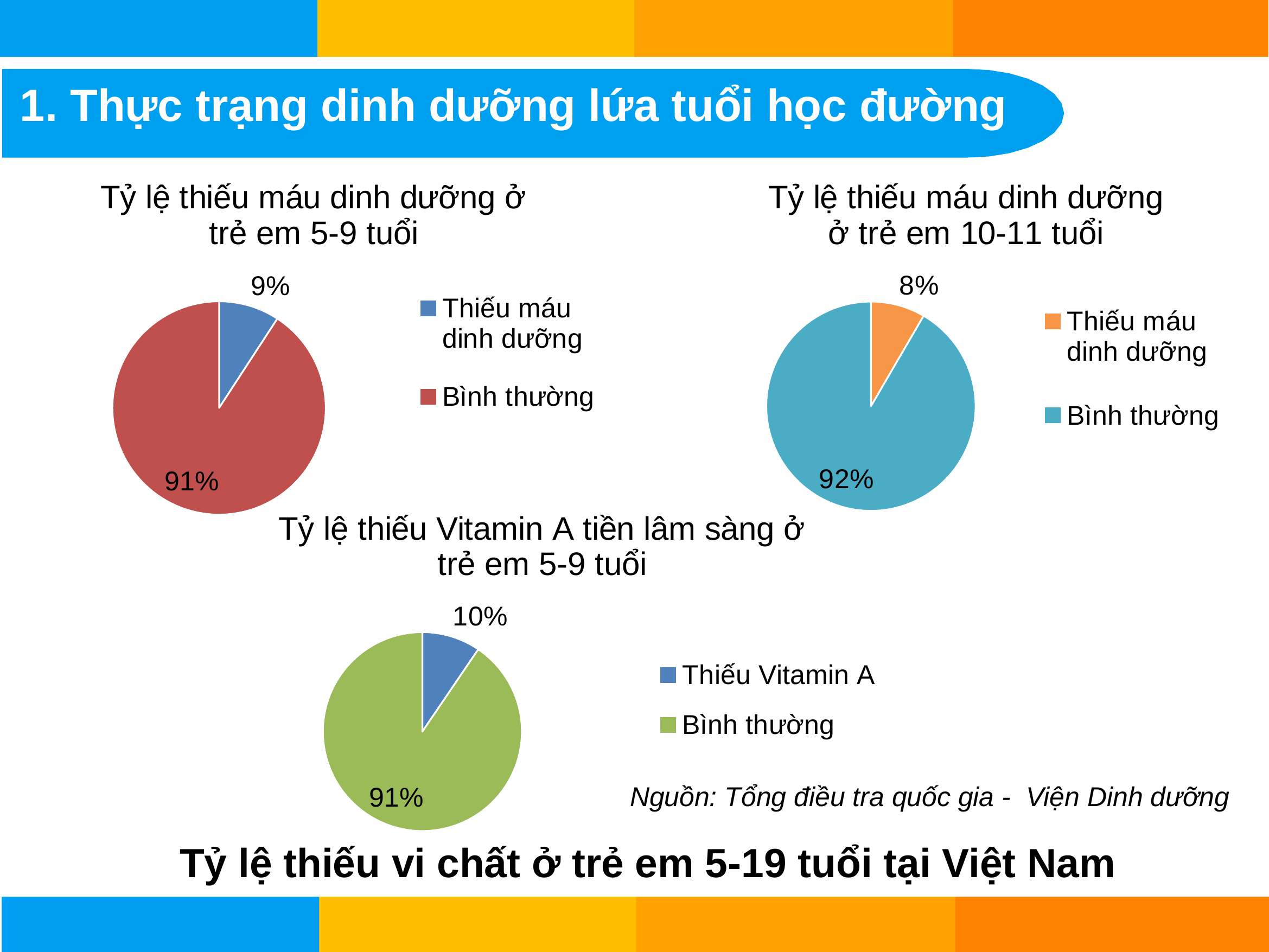
In the chart titled 'Tỷ lệ thiếu máu dinh dưỡng ở trẻ em 5-9 tuổi', what is the difference between 'Bình thường' and 'Thiếu máu dinh dưỡng'? 82% In the chart titled 'Tỷ lệ thiếu máu dinh dưỡng ở trẻ em 10-11 tuổi', what is the value for 'Bình thường'? 92% In the chart titled 'Tỷ lệ thiếu Vitamin A tiền lâm sàng ở trẻ em 5-9 tuổi', what is the value for 'Thiếu Vitamin A'? 10% In the chart titled 'Tỷ lệ thiếu máu dinh dưỡng ở trẻ em 10-11 tuổi', what is the value for 'Thiếu máu dinh dưỡng'? 8% How many slices does the chart titled 'Tỷ lệ thiếu máu dinh dưỡng ở trẻ em 10-11 tuổi' have? 2 What kind of chart is the chart titled 'Tỷ lệ thiếu máu dinh dưỡng ở trẻ em 5-9 tuổi'? Pie chart In the chart titled 'Tỷ lệ thiếu Vitamin A tiền lâm sàng ở trẻ em 5-9 tuổi', what is the value for 'Bình thường'? 91% In the chart titled 'Tỷ lệ thiếu máu dinh dưỡng ở trẻ em 10-11 tuổi', what colour is the 'Thiếu máu dinh dưỡng' slice? Orange In the chart titled 'Tỷ lệ thiếu máu dinh dưỡng ở trẻ em 10-11 tuổi', which category is the largest? Bình thường In the chart titled 'Tỷ lệ thiếu máu dinh dưỡng ở trẻ em 5-9 tuổi', what is the value for 'Bình thường'? 91% In the chart titled 'Tỷ lệ thiếu máu dinh dưỡng ở trẻ em 5-9 tuổi', what is the value for 'Thiếu máu dinh dưỡng'? 9% In the chart titled 'Tỷ lệ thiếu Vitamin A tiền lâm sàng ở trẻ em 5-9 tuổi', which category is the smallest? Thiếu Vitamin A